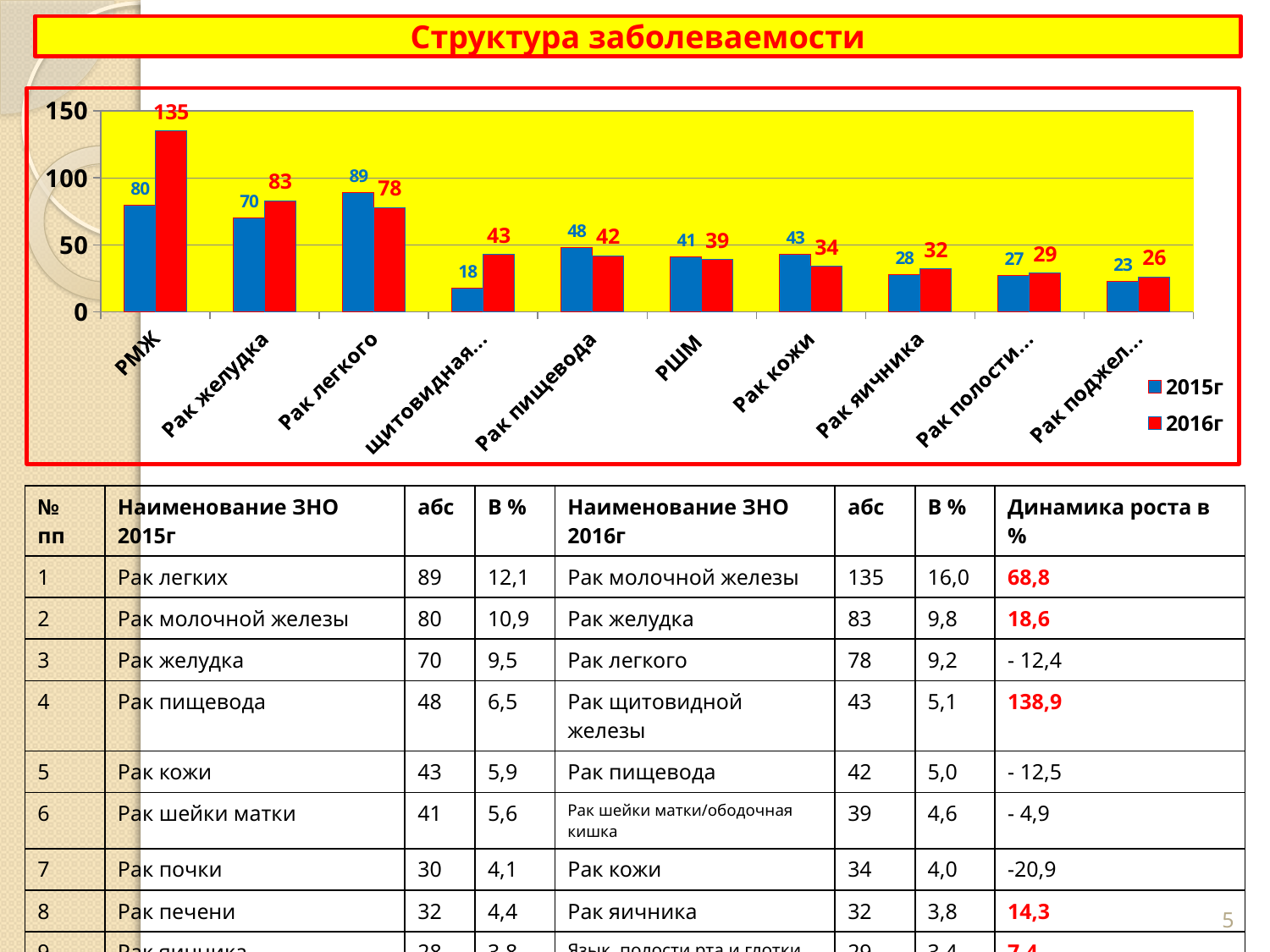
What colour are the 2016г bars? red What is the 2016г value for РМЖ? 135 How many series does the legend list? 2 What is the difference between the 2016г and 2015г values for РМЖ? 55 Is the 2016г value for Рак желудка greater or less than 50? greater Which is larger for Рак легкого: the 2015г value or the 2016г value? 2015г Which category has the lowest 2015г value? Щитовидная... What kind of chart is shown on the slide? bar chart Which category has the highest 2016г value? РМЖ How many categories are shown on the x axis? 10 What is the 2015г value for Рак пищевода? 48 What is the 2015г value for Рак легкого? 89